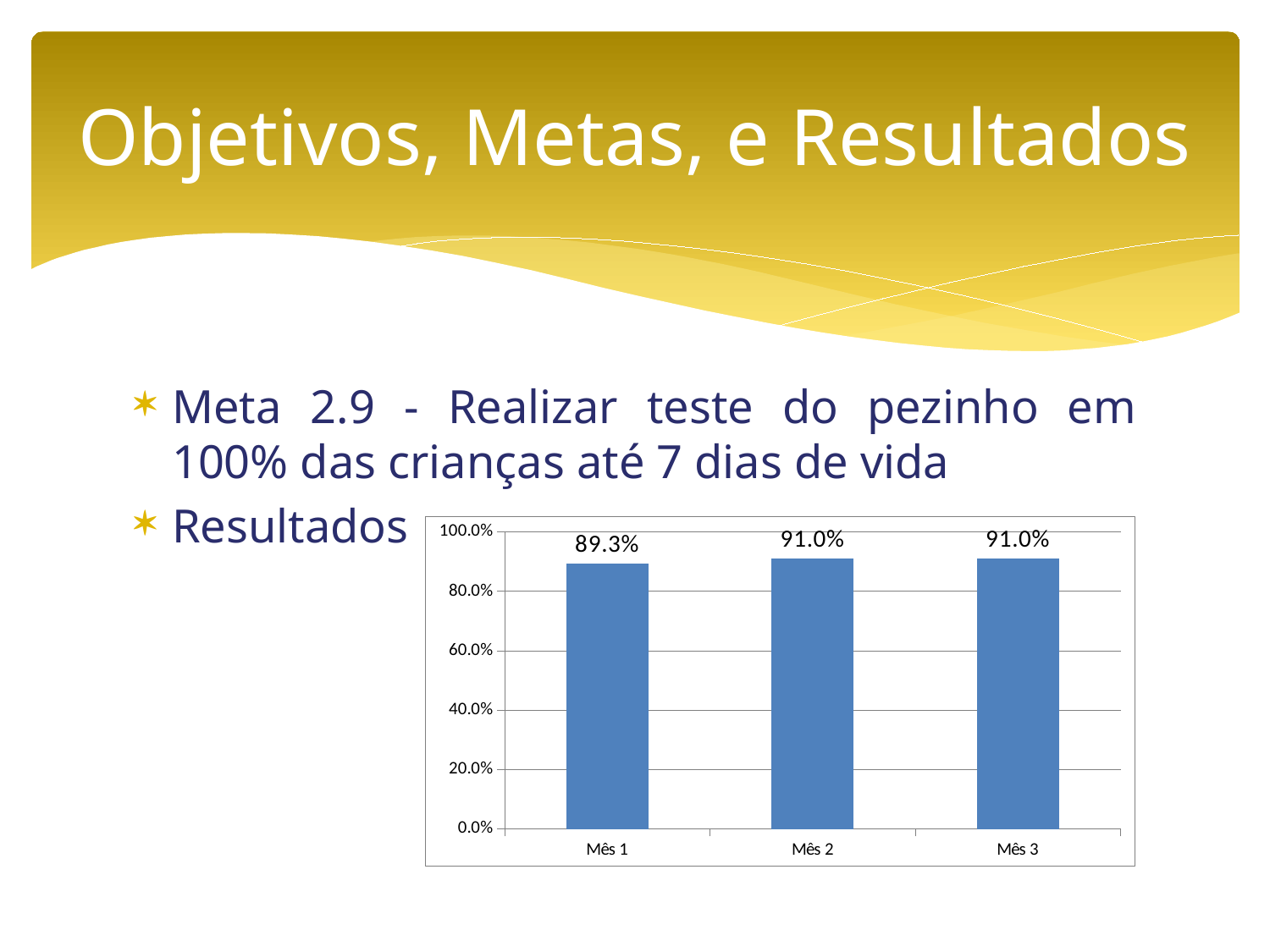
Is the value for Mês 3 greater or less than 80.0%? greater What is the difference between the values for Mês 2 and Mês 1? 1.7% What is the value for Mês 3? 91.0% What is the value for Mês 2? 91.0% How many categories are shown on the x axis? 3 Do the values rise or fall from Mês 1 to Mês 2? rise What is the value for Mês 1? 89.3% Which category has the lowest value? Mês 1 Which is larger, the value for Mês 1 or the value for Mês 2? Mês 2 What kind of chart is shown on the slide? bar chart Is the value for Mês 1 greater or less than 100.0%? less What is the highest value shown on the y axis? 100.0%